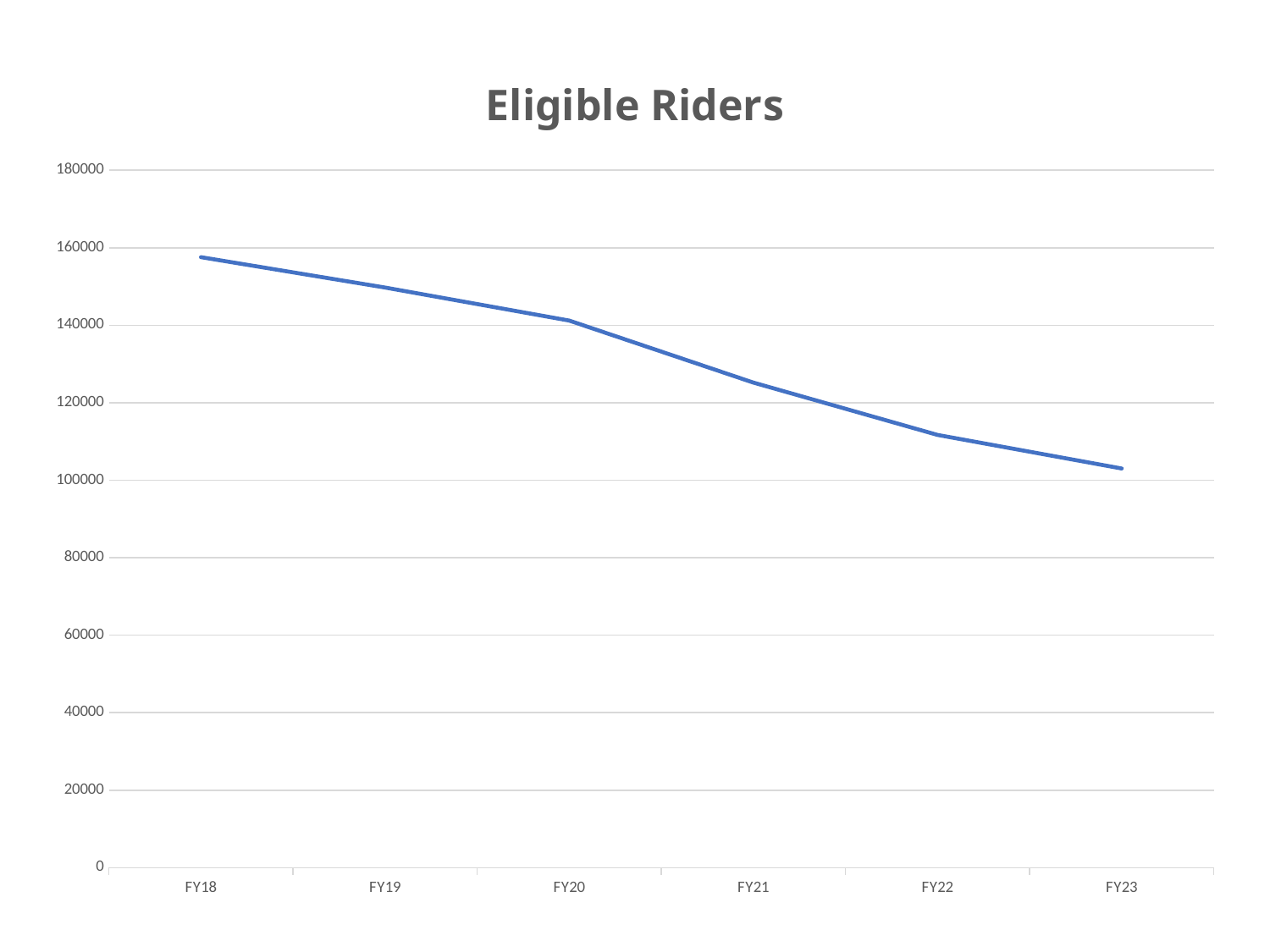
Do the values rise or fall from FY18 to FY23? fall What kind of chart is shown on the slide? line chart How many fiscal years are plotted on the x axis? 6 What is the title of the chart? Eligible Riders Is the value for FY22 greater or less than 120000? less Is the value for FY18 greater or less than 140000? greater Is the value for FY23 greater or less than 120000? less Which is larger, the value for FY20 or the value for FY22? FY20 Which fiscal year has the lowest number of eligible riders? FY23 Which fiscal year has the highest number of eligible riders? FY18